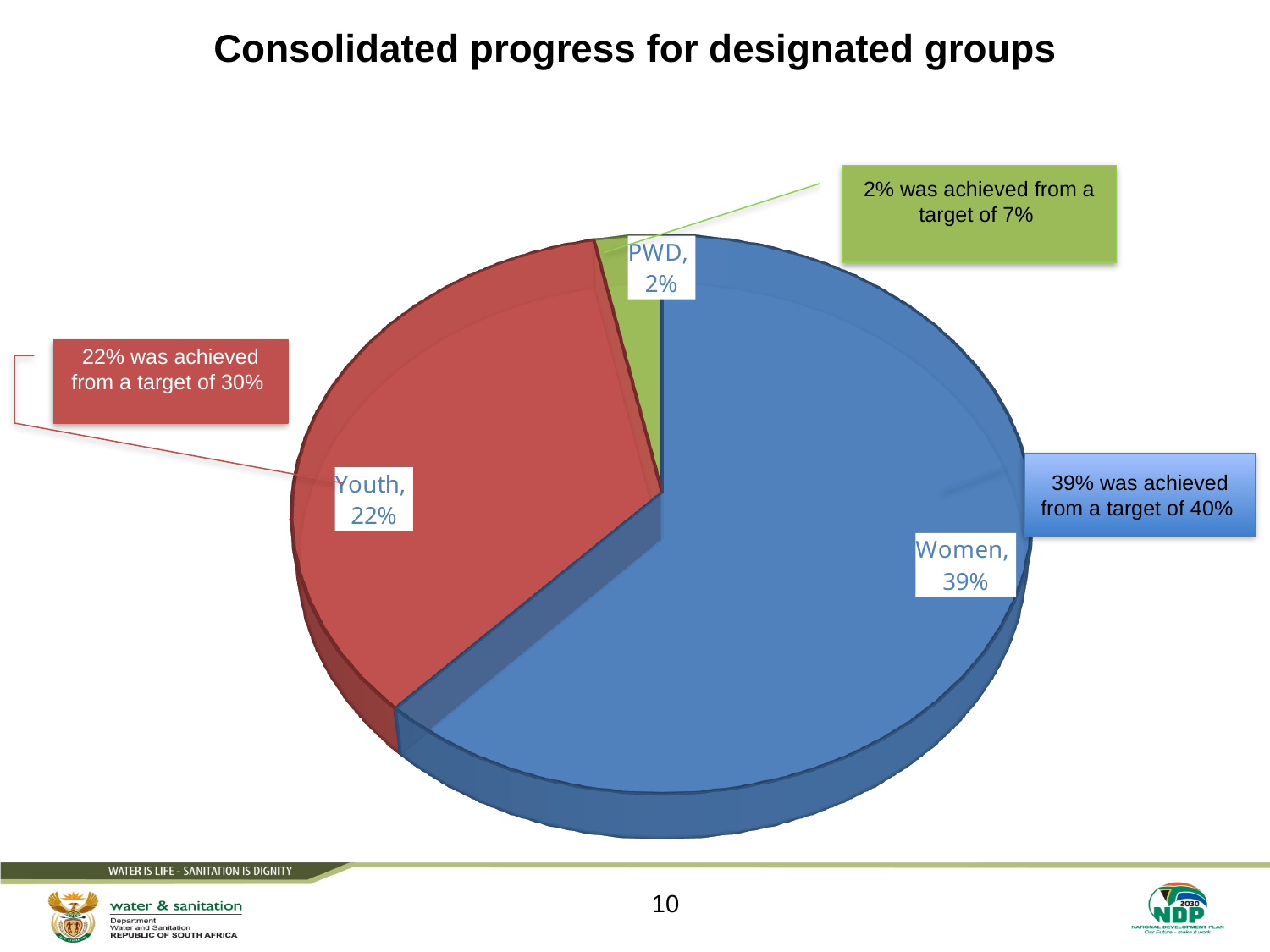
What kind of chart is shown on the slide? pie chart What is the difference between the values for Women and Youth? 17% What value is shown for Women in the pie chart? 39% According to the callout, what was the target for Youth? 30% How many slices does the pie chart have? 3 What is the difference between the values for Youth and PWD? 20% Which group has the largest slice in the pie chart? Women What is the title of the slide containing the pie chart? Consolidated progress for designated groups What value is shown for PWD in the pie chart? 2% Which is larger, the value for Youth or the value for PWD? Youth Which group has the smallest slice in the pie chart? PWD What value is shown for Youth in the pie chart? 22%